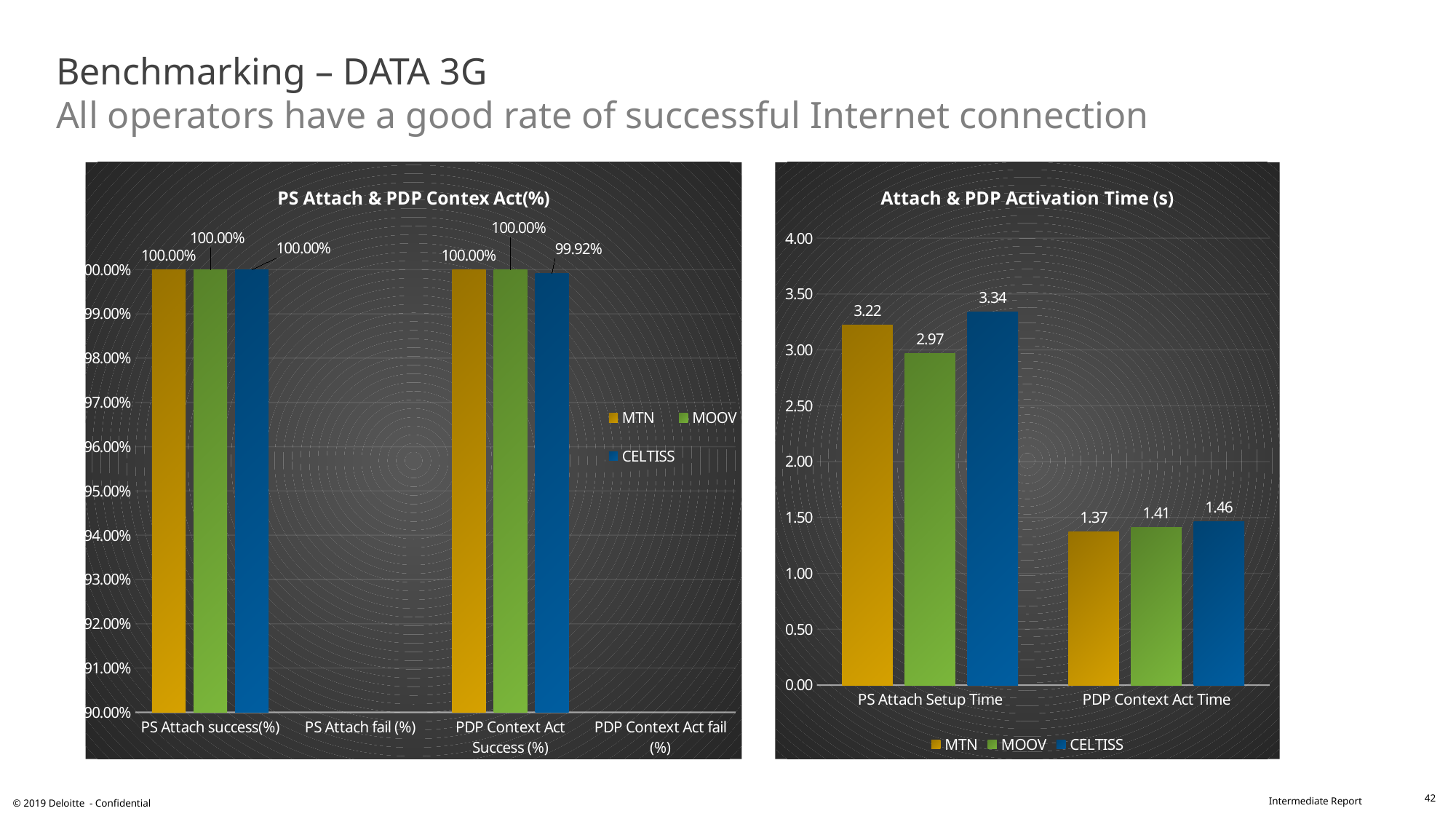
How many categories are shown on the x axis of the 'PS Attach & PDP Contex Act(%)' chart? 4 How many series does the legend of the 'Attach & PDP Activation Time (s)' chart list? 3 In the 'Attach & PDP Activation Time (s)' chart, what is the PS Attach Setup Time for CELTISS? 3.34 In the 'Attach & PDP Activation Time (s)' chart, is the PS Attach Setup Time for MTN greater or less than 3.00? greater In the 'PS Attach & PDP Contex Act(%)' chart, what is the PDP Context Act Success (%) value for CELTISS? 99.92% In the 'PS Attach & PDP Contex Act(%)' chart, which operator has the lowest PDP Context Act Success (%)? CELTISS In the 'Attach & PDP Activation Time (s)' chart, which operator has the lowest PS Attach Setup Time? MOOV In the 'Attach & PDP Activation Time (s)' chart, what is the difference between the PS Attach Setup Time of CELTISS and MOOV? 0.37 In the 'Attach & PDP Activation Time (s)' chart, which has the larger PDP Context Act Time, MTN or CELTISS? CELTISS What kind of chart is the 'PS Attach & PDP Contex Act(%)' chart? bar chart In the 'Attach & PDP Activation Time (s)' chart, which operator has the highest PS Attach Setup Time? CELTISS In the 'Attach & PDP Activation Time (s)' chart, what is the PDP Context Act Time for MOOV? 1.41